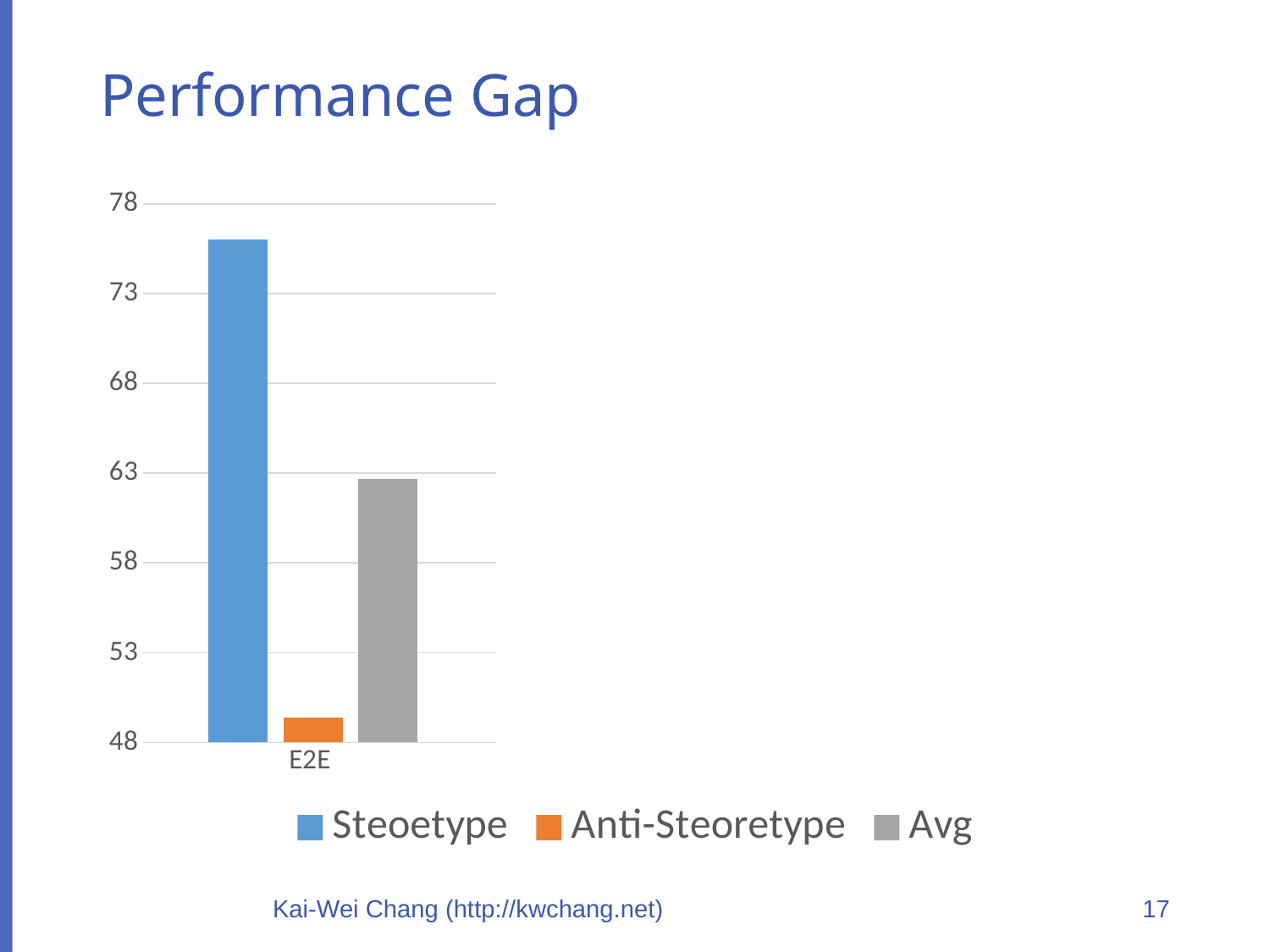
What kind of chart is shown on the slide? bar chart Is the Avg value for E2E greater or less than 58? greater What colour are the Avg bars in the chart? gray Is the Steoetype value for E2E greater or less than 73? greater Which is larger for E2E, the Steoetype value or the Avg value? Steoetype Which is larger for E2E, the Avg value or the Anti-Steoretype value? Avg Which series has the lowest value for E2E? Anti-Steoretype Which series has the highest value for E2E? Steoetype How many categories are shown on the x axis? 1 How many series does the legend list? 3 What is the title of the slide containing the chart? Performance Gap Is the Anti-Steoretype value for E2E greater or less than 53? less